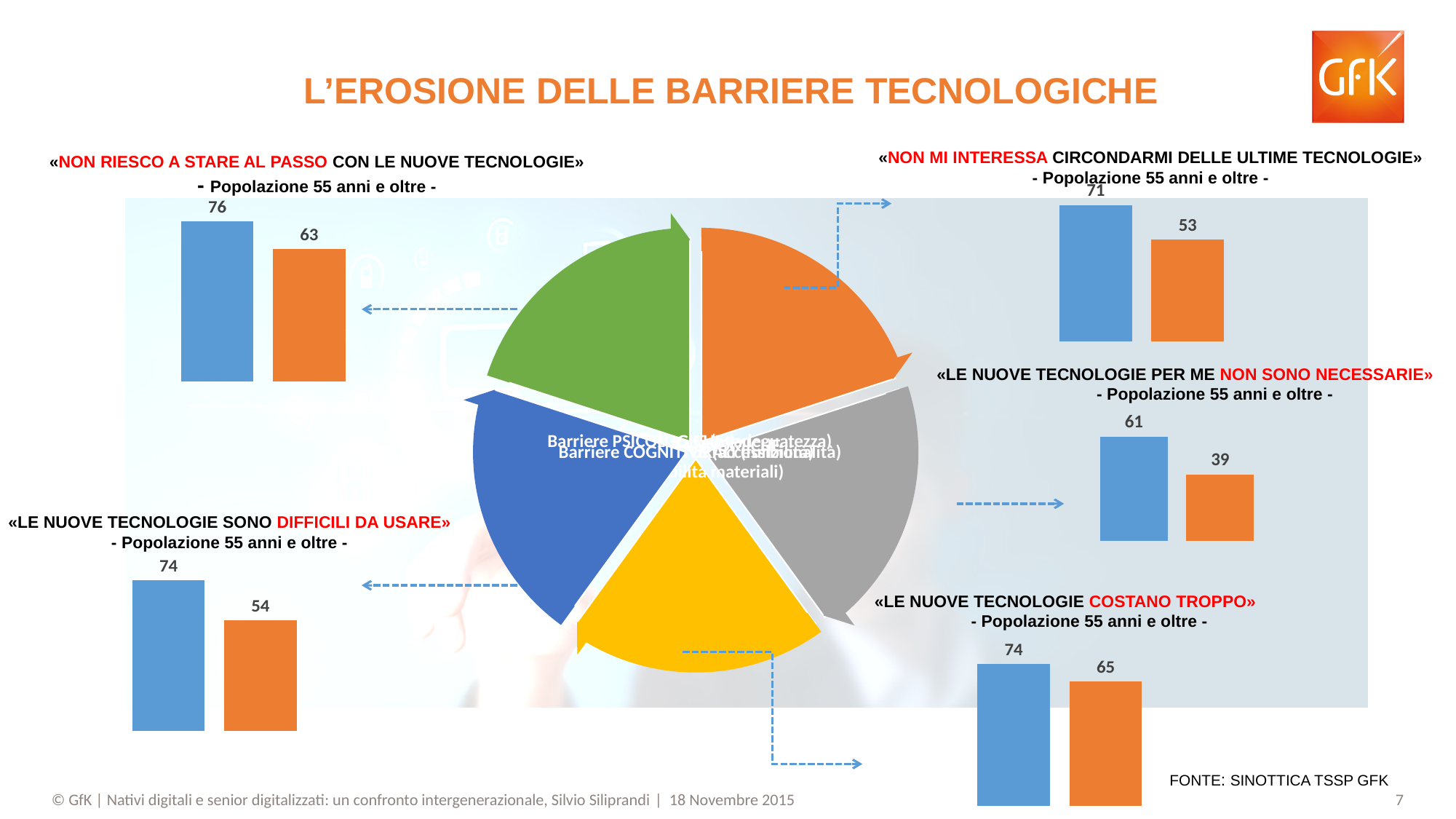
In the chart titled «LE NUOVE TECNOLOGIE PER ME NON SONO NECESSARIE», what is the value of the blue bar? 61 How many small bar charts are shown on the slide? 5 Across the five bar charts on the slide, which chart has the lowest orange bar value? «LE NUOVE TECNOLOGIE PER ME NON SONO NECESSARIE» In the chart titled «LE NUOVE TECNOLOGIE SONO DIFFICILI DA USARE», what is the difference between the blue bar and the orange bar? 20 In the chart titled «NON MI INTERESSA CIRCONDARMI DELLE ULTIME TECNOLOGIE», how many bars are plotted? 2 What kind of chart is the one titled «LE NUOVE TECNOLOGIE SONO DIFFICILI DA USARE»? bar chart In the chart titled «NON RIESCO A STARE AL PASSO CON LE NUOVE TECNOLOGIE», what is the value of the orange bar? 63 In the chart titled «LE NUOVE TECNOLOGIE PER ME NON SONO NECESSARIE», what is the difference between the blue bar and the orange bar? 22 In the chart titled «LE NUOVE TECNOLOGIE COSTANO TROPPO», what is the value of the orange bar? 65 In the chart titled «NON RIESCO A STARE AL PASSO CON LE NUOVE TECNOLOGIE», what is the value of the blue bar? 76 In the chart titled «NON MI INTERESSA CIRCONDARMI DELLE ULTIME TECNOLOGIE», what is the value of the orange bar? 53 In the chart titled «LE NUOVE TECNOLOGIE COSTANO TROPPO», which bar is larger, the blue bar or the orange bar? the blue bar